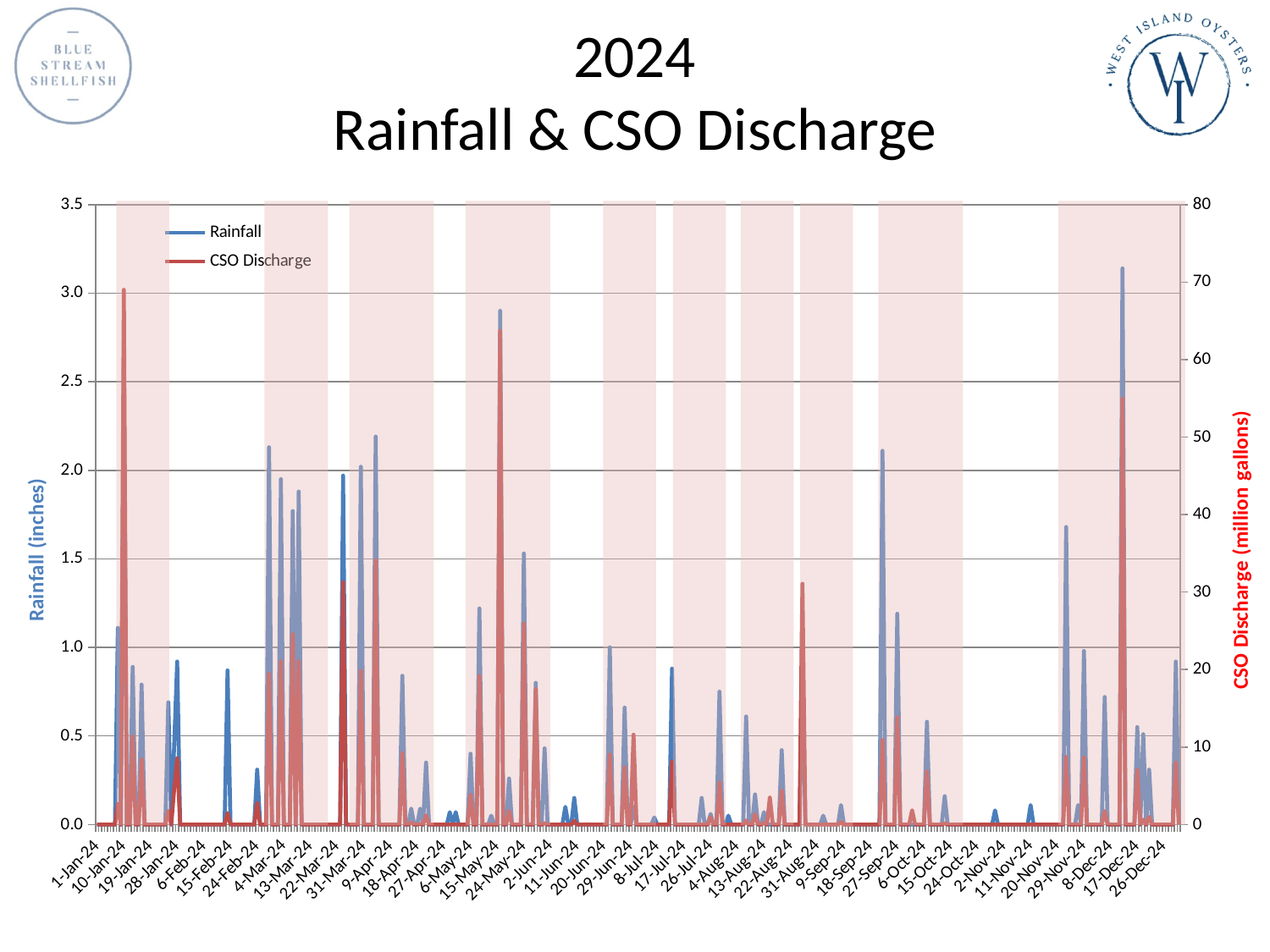
Is the highest Rainfall peak of the year greater or less than 3.0 inches? greater What is the title of the chart? 2024 Rainfall & CSO Discharge Is the highest CSO Discharge peak of the year (in January) greater or less than 60 million gallons? greater Is the CSO Discharge peak in late August greater or less than 40 million gallons? less What is the highest value shown on the right-hand CSO Discharge axis? 80 How many series does the legend list? 2 Which series is plotted in blue? Rainfall What kind of chart is shown on the slide? Line chart What is the label of the right-hand vertical axis? CSO Discharge (million gallons) What is the highest value shown on the left-hand Rainfall axis? 3.5 What is the label of the left-hand vertical axis? Rainfall (inches)